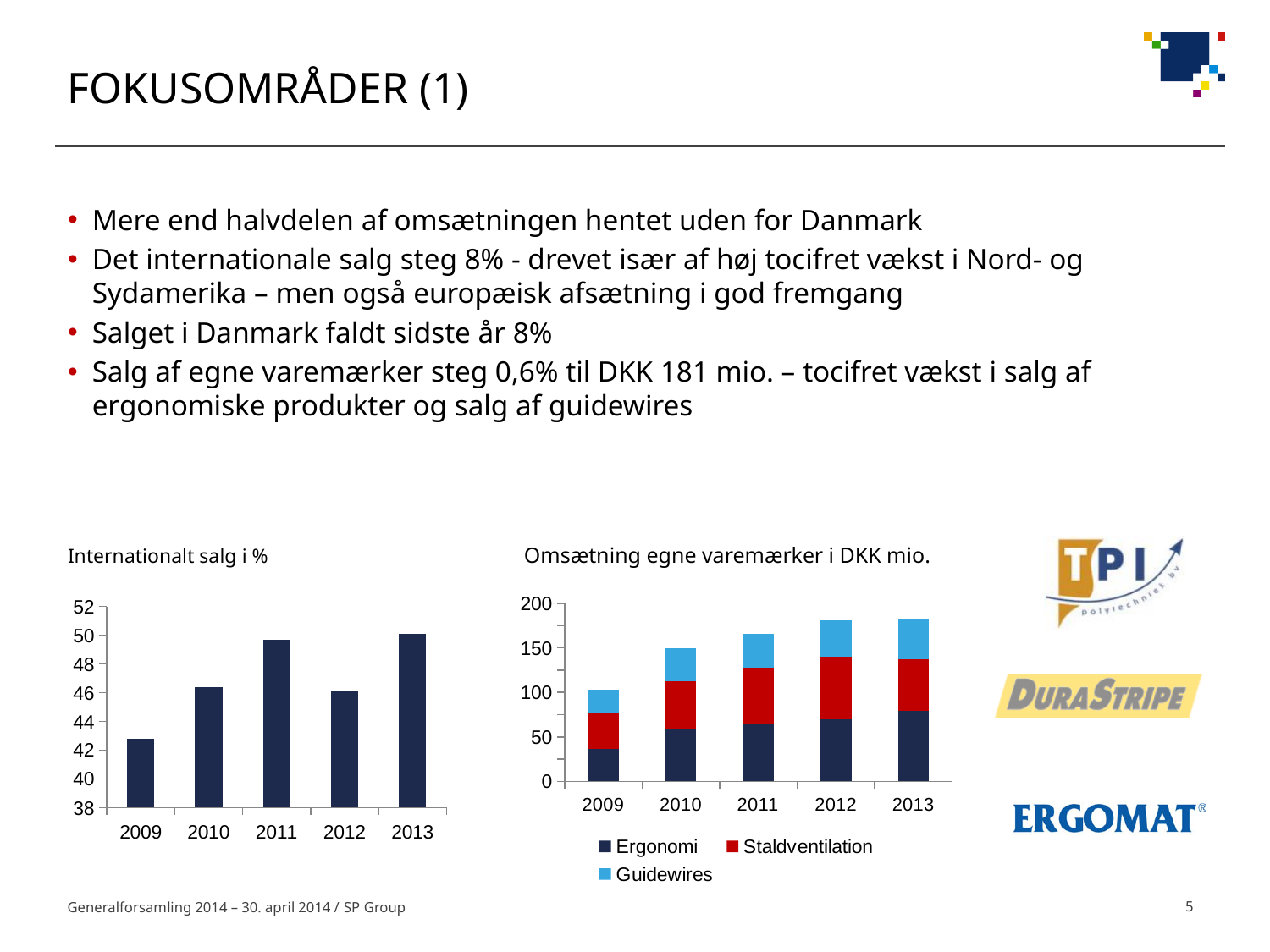
In the chart titled "Internationalt salg i %", which year has the lowest value? 2009 In the chart titled "Omsætning egne varemærker i DKK mio.", how many series does the legend list? 3 In the chart titled "Omsætning egne varemærker i DKK mio.", which year has the lowest total bar? 2009 In the chart titled "Internationalt salg i %", is the value for 2012 greater or less than 48? less In the chart titled "Internationalt salg i %", is the value for 2011 greater or less than 48? greater What kind of chart is the chart titled "Omsætning egne varemærker i DKK mio."? Stacked bar chart In the chart titled "Omsætning egne varemærker i DKK mio.", which series is shown in red? Staldventilation In the chart titled "Internationalt salg i %", which is larger, the value for 2011 or the value for 2012? 2011 In the chart titled "Internationalt salg i %", is the value for 2009 greater or less than 44? less In the chart titled "Internationalt salg i %", how many years are shown on the x axis? 5 In the chart titled "Omsætning egne varemærker i DKK mio.", do the total bar heights rise or fall from 2009 to 2013? rise